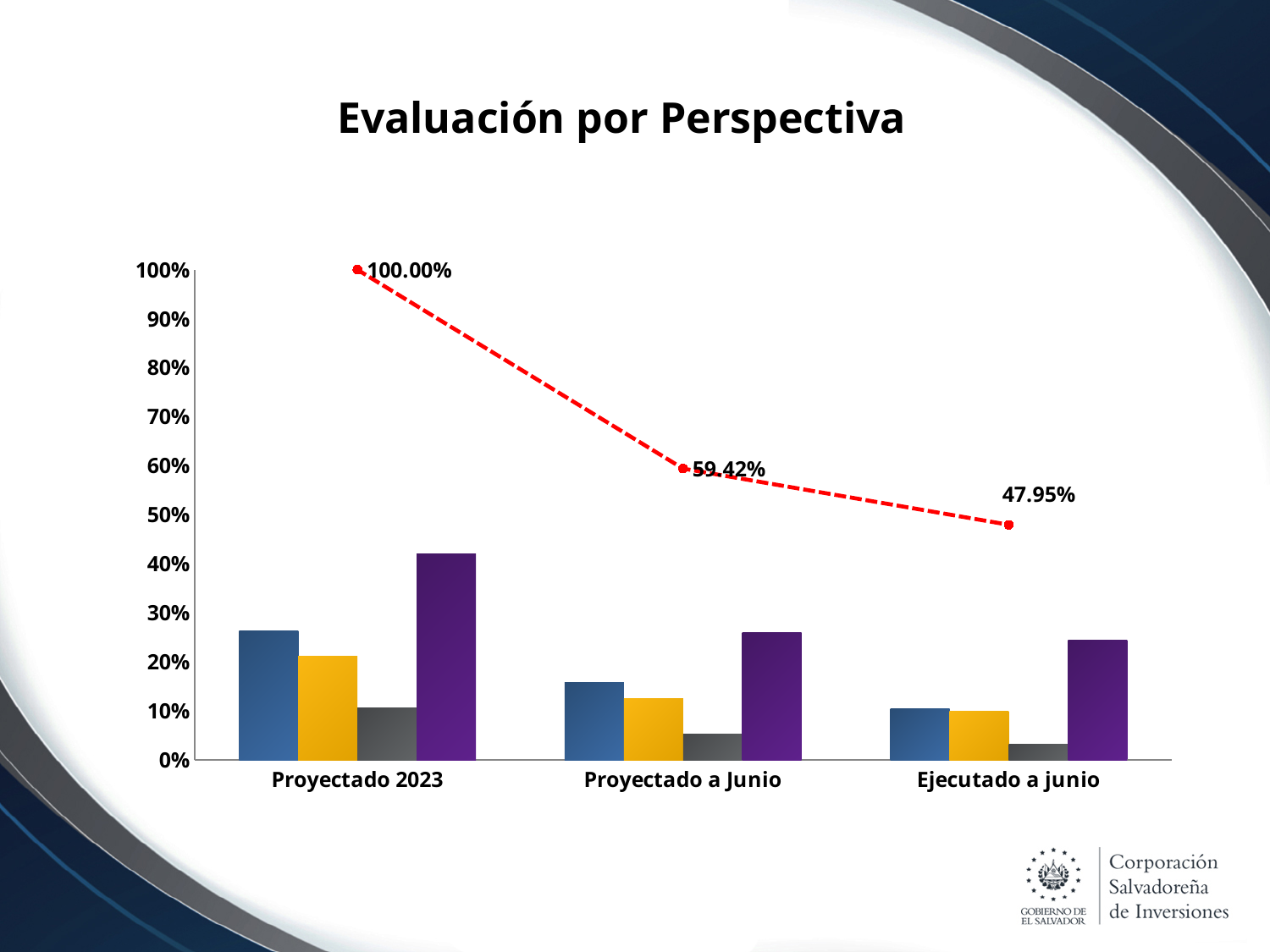
What is the title of the chart? Evaluación por Perspectiva Which category has the lowest value on the dashed red line? Ejecutado a junio What is the value of the dashed red line for Ejecutado a junio? 47.95% What is the difference between the dashed red line values for Proyectado 2023 and Proyectado a Junio? 40.58% What is the value of the dashed red line for Proyectado a Junio? 59.42% Does the dashed red line rise or fall from Proyectado 2023 to Ejecutado a junio? fall What is the value of the dashed red line for Proyectado 2023? 100.00% What is the difference between the dashed red line values for Proyectado a Junio and Ejecutado a junio? 11.47% Which category has the highest value on the dashed red line? Proyectado 2023 Is the value of the blue bar for Proyectado 2023 greater or less than 20%? greater Is the value of the gray bar for Ejecutado a junio greater or less than 10%? less How many categories are shown on the x axis? 3